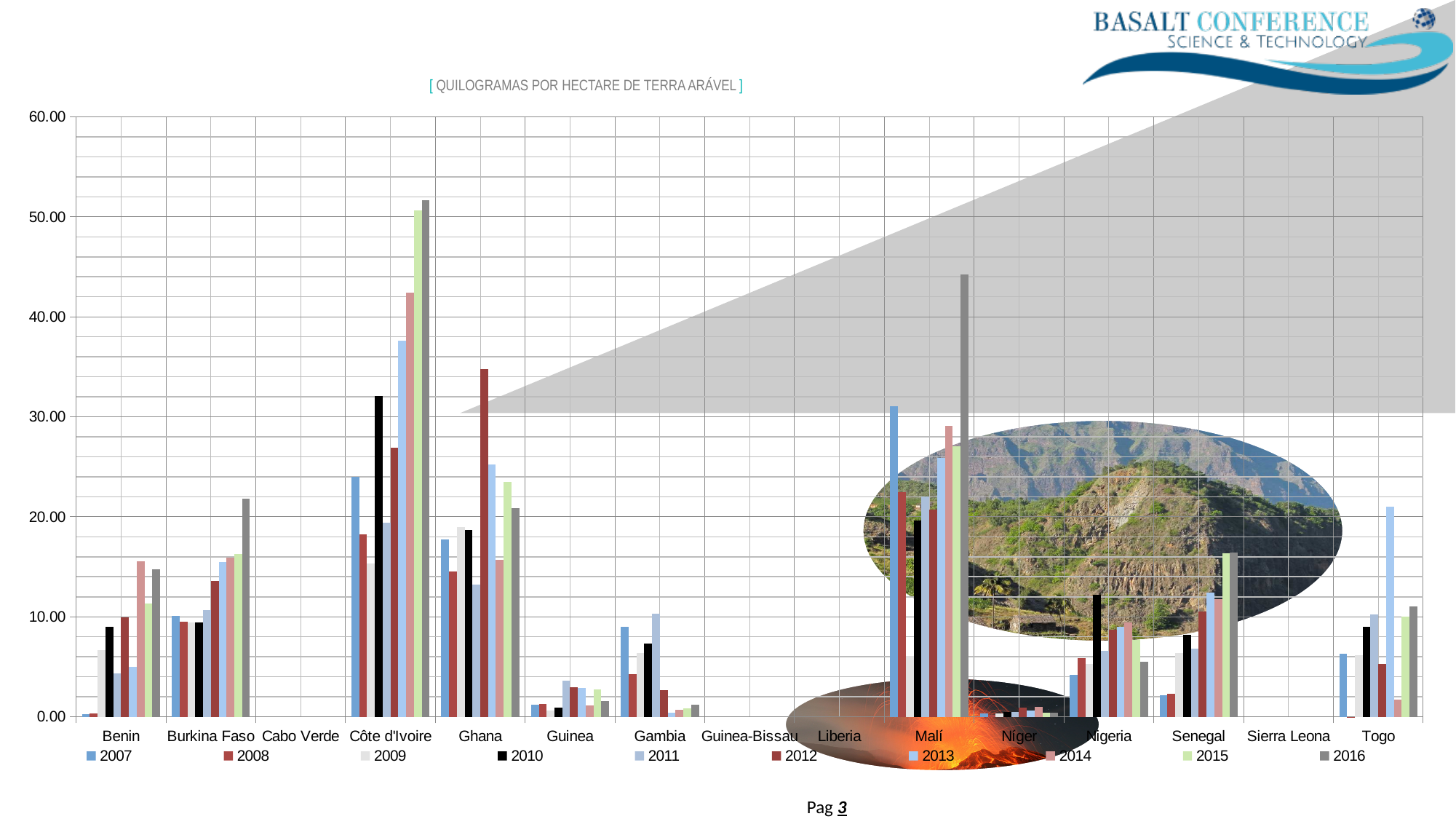
Is the 2011 value for Guinea greater or less than 10.00? less What kind of chart is shown on the slide? bar chart How many series (years) does the chart legend list? 10 Is the 2012 value for Ghana greater or less than 30.00? greater Is the 2013 value for Togo greater or less than 20.00? greater For Côte d'Ivoire, do the bars from 2013 to 2016 rise or fall? rise What is the title of the chart? [ QUILOGRAMAS POR HECTARE DE TERRA ARÁVEL ] Which is larger: the 2016 value for Côte d'Ivoire or the 2016 value for Malí? Côte d'Ivoire Which country has the tallest bar in the chart? Côte d'Ivoire How many countries (categories) are listed along the x axis of the chart? 15